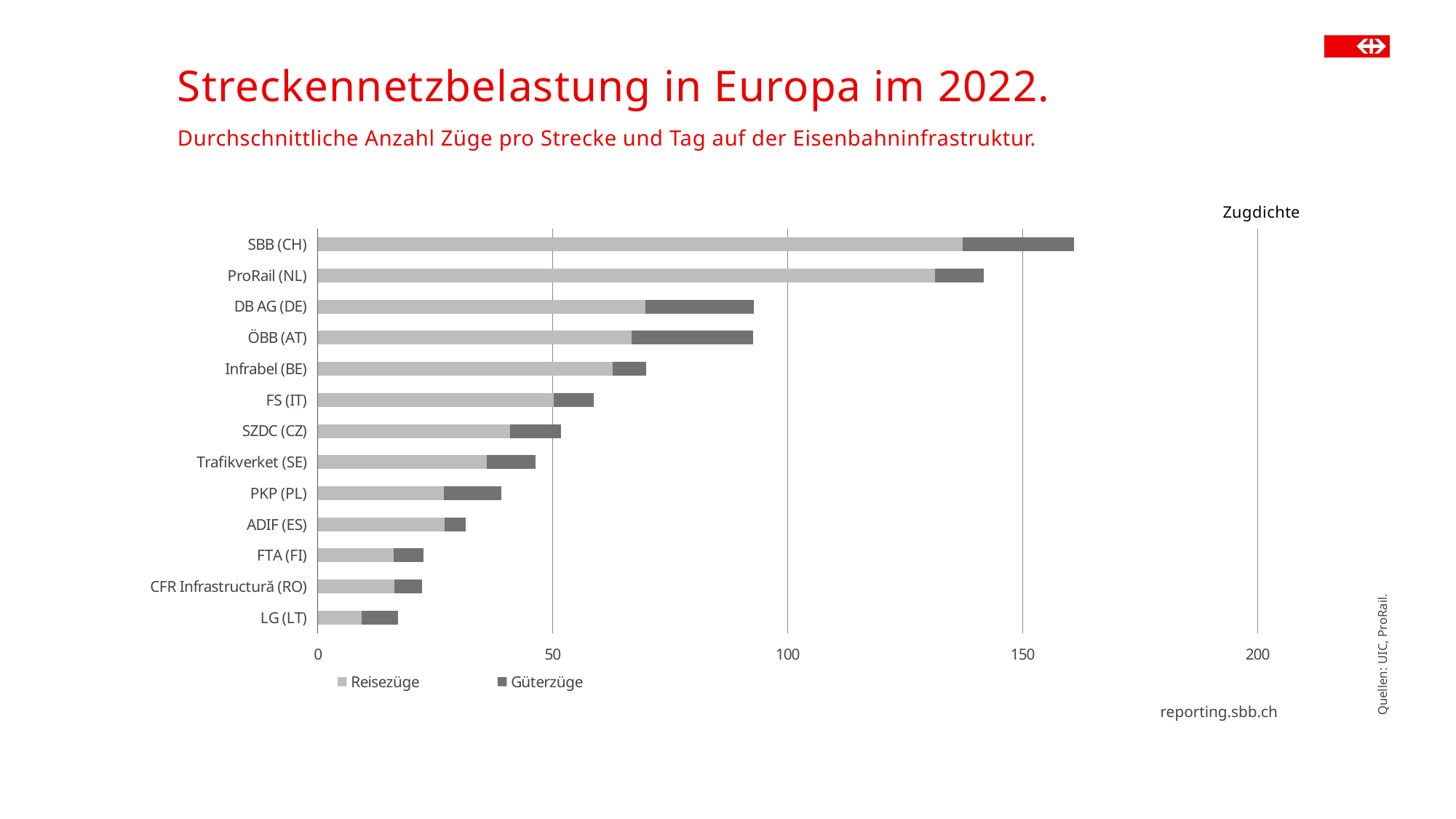
Is the Reisezüge value for SBB (CH) greater or less than 100? greater What are the two series named in the legend? Reisezüge and Güterzüge Is the total value for DB AG (DE) greater or less than 100? less Which has the larger total value, Infrabel (BE) or FS (IT)? Infrabel (BE) How many railway infrastructure operators (categories) are shown in the chart? 13 Is the total value for Trafikverket (SE) greater or less than 50? less Which operator has the highest total train density (Zugdichte)? SBB (CH) What kind of chart is shown on the slide? bar chart How many series does the legend list? 2 Which operator has the lowest total train density (Zugdichte)? LG (LT)